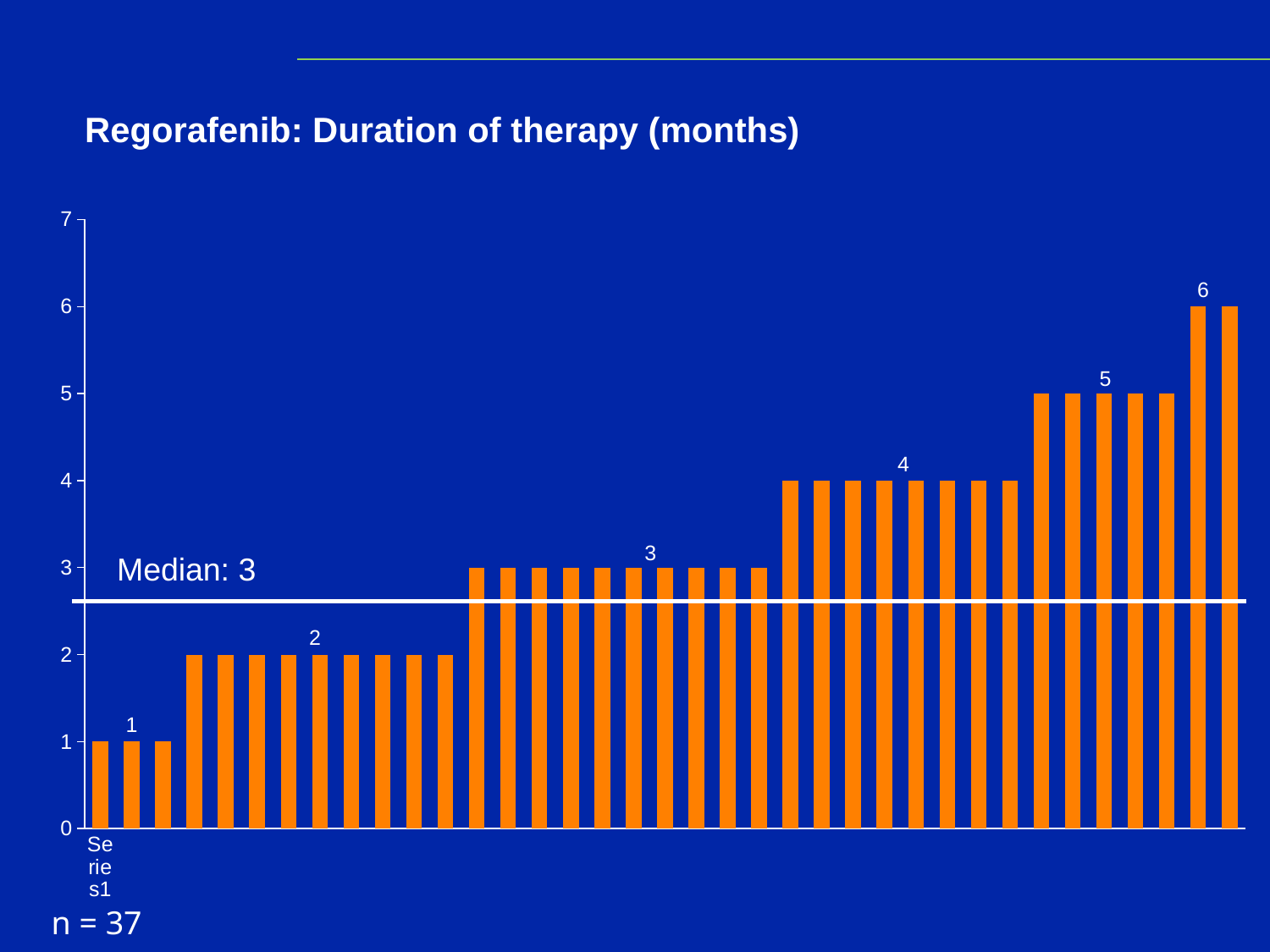
What is the value of the first bar on the left? 1 What is the lowest duration of therapy shown in the chart? 1 How many bars reach a value of 6 months? 2 What is the highest duration of therapy shown in the chart? 6 What median value is annotated on the chart? 3 What is the title of the chart? Regorafenib: Duration of therapy (months) What kind of chart is shown on the slide? bar chart What is the difference between the highest and lowest bar values in the chart? 5 How many bars have a value of 1 month? 3 How many bars (patients) are plotted in the chart? 37 Do the bar values rise or fall from left to right along the x axis? rise Is the value of the last bar on the right greater or less than 5? greater